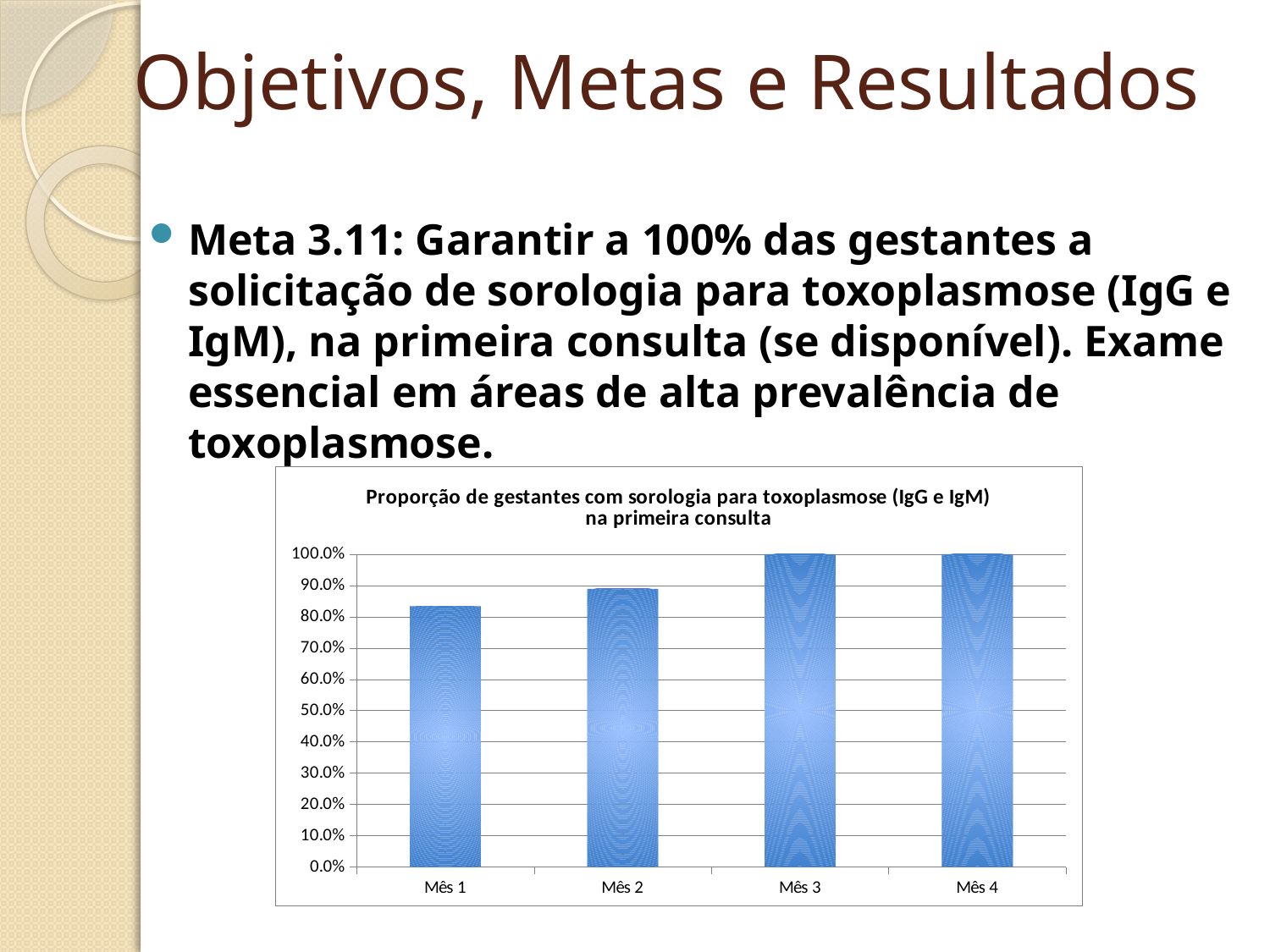
Which month has the lowest proportion in the chart? Mês 1 What colour are the bars in the chart? blue Which is larger, the value for Mês 1 or the value for Mês 2? Mês 2 What is the value for Mês 4? 100.0% Is the value for Mês 2 greater or less than 80.0%? greater Do the values rise or fall from Mês 1 to Mês 4? rise What is the value for Mês 3? 100.0% How many categories (months) are shown on the x axis of the chart? 4 Is the value for Mês 1 greater or less than 90.0%? less What kind of chart is shown on the slide? bar chart What is the title of the chart? Proporção de gestantes com sorologia para toxoplasmose (IgG e IgM) na primeira consulta Is the value for Mês 1 greater or less than 80.0%? greater